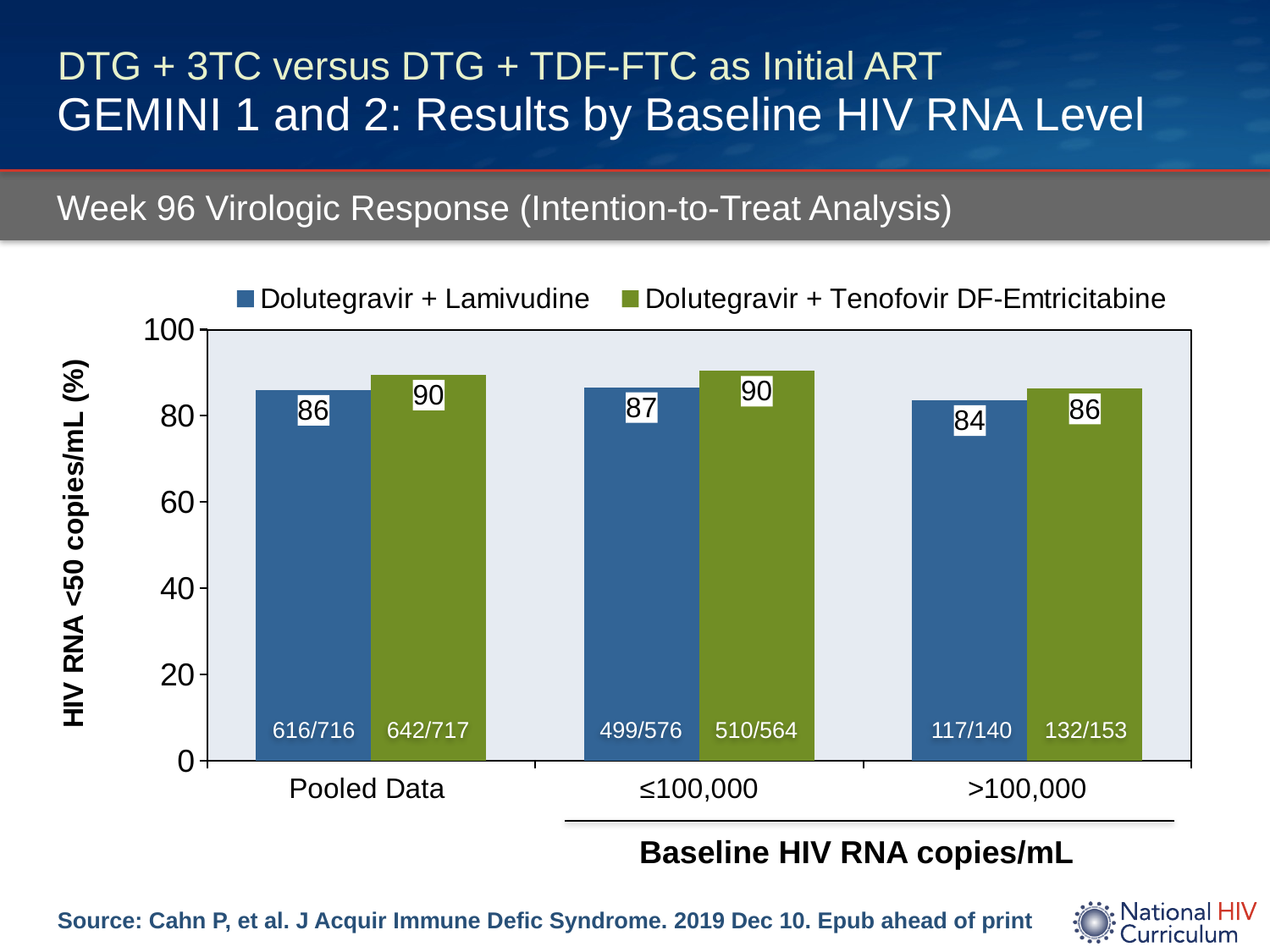
What is the value for Dolutegravir + Tenofovir DF-Emtricitabine in the Pooled Data group? 90 What is the difference between the two treatment arms in the ≤100,000 baseline HIV RNA group? 3 What is the difference between the Dolutegravir + Tenofovir DF-Emtricitabine and Dolutegravir + Lamivudine values in the Pooled Data group? 4 How many series does the legend list? 2 In the >100,000 group, which arm has the higher value: Dolutegravir + Lamivudine or Dolutegravir + Tenofovir DF-Emtricitabine? Dolutegravir + Tenofovir DF-Emtricitabine What is the Week 96 virologic response for Dolutegravir + Lamivudine in the Pooled Data group? 86 How many baseline HIV RNA categories are shown on the x axis? 3 What is the value for Dolutegravir + Tenofovir DF-Emtricitabine in the >100,000 baseline HIV RNA group? 86 Which baseline HIV RNA category has the lowest value for Dolutegravir + Lamivudine? >100,000 What is the value for Dolutegravir + Lamivudine in the ≤100,000 baseline HIV RNA group? 87 What kind of chart is shown on the slide? Bar chart What is the label of the y axis? HIV RNA <50 copies/mL (%)